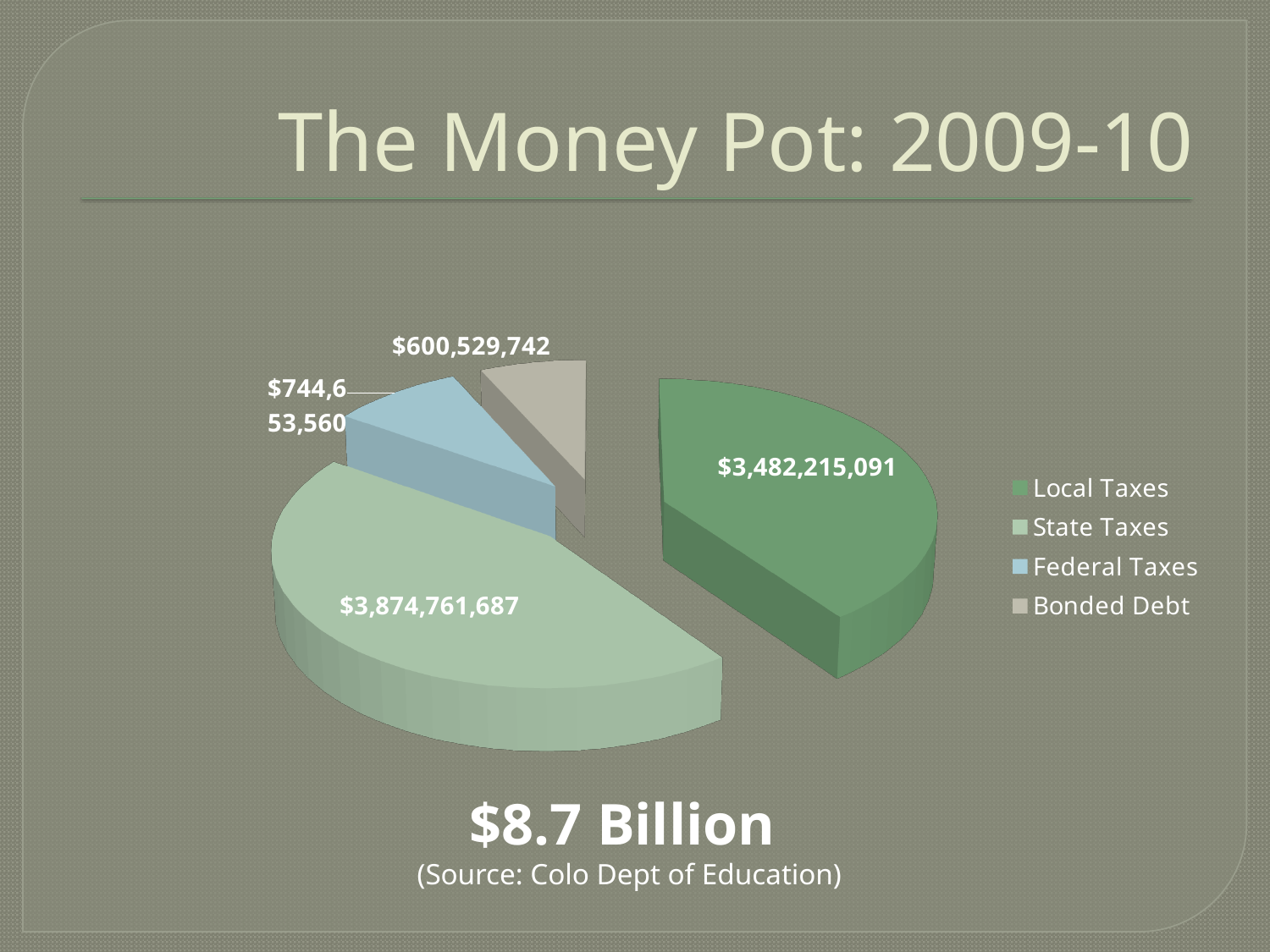
Which category has the largest slice? State Taxes What is the value for State Taxes? $3,874,761,687 How many entries does the legend list? 4 Which is larger, Federal Taxes or Bonded Debt? Federal Taxes What is the value for Local Taxes? $3,482,215,091 What is the title of the slide containing the chart? The Money Pot: 2009-10 What is the difference between State Taxes and Local Taxes? $392,546,596 Which category has the smallest slice? Bonded Debt What is the value for Bonded Debt? $600,529,742 What is the value for Federal Taxes? $744,653,560 What kind of chart is shown on the slide? pie chart How many slices does the pie chart have? 4